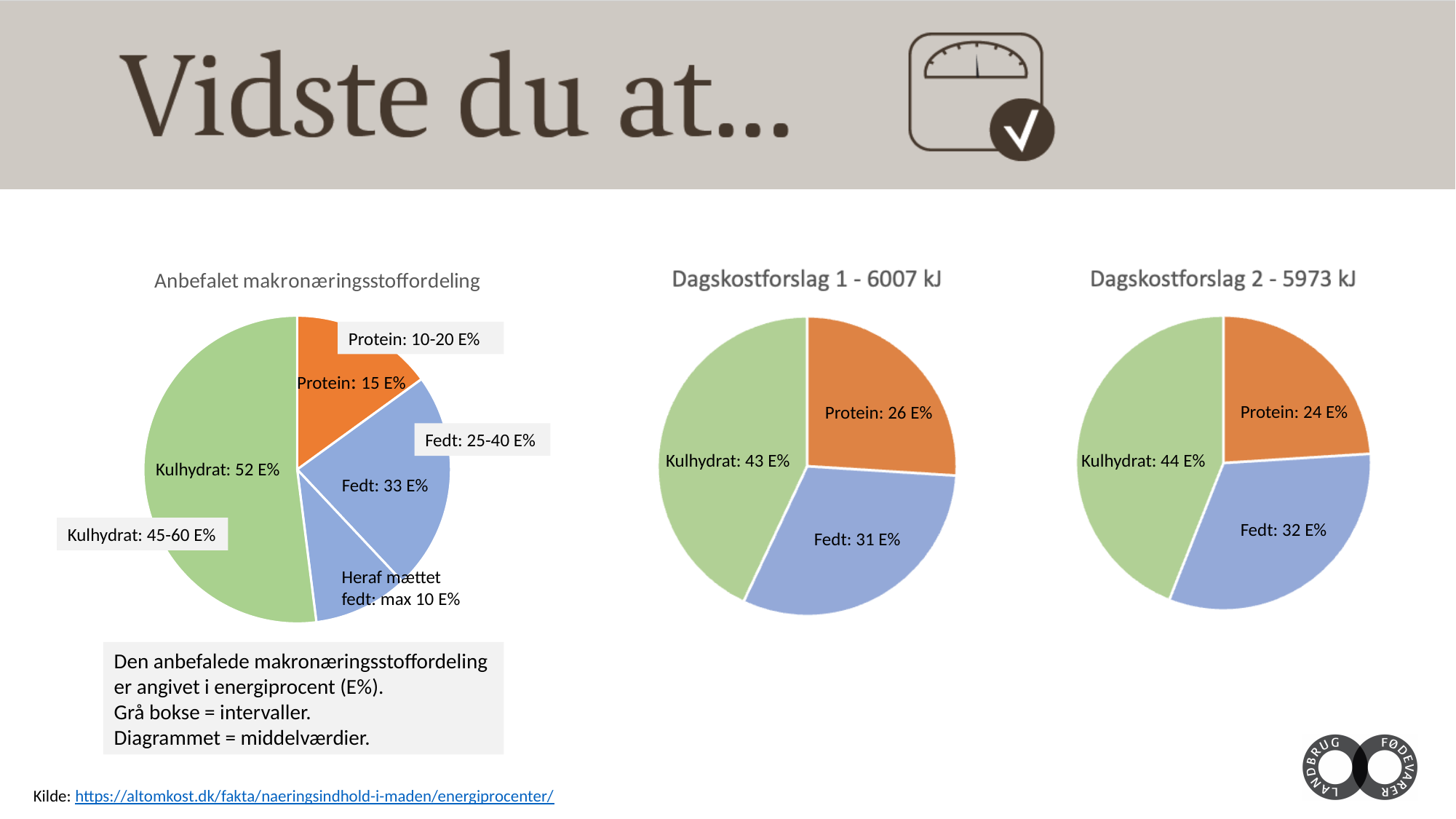
In the chart titled 'Dagskostforslag 1 - 6007 kJ', what is the value for Protein? 26 E% What kind of chart is 'Dagskostforslag 2 - 5973 kJ'? Pie chart In the chart titled 'Anbefalet makronæringsstoffordeling', which category has the smallest slice? Heraf mættet fedt In the chart titled 'Anbefalet makronæringsstoffordeling', what is the value for Kulhydrat? 52 E% In the chart titled 'Dagskostforslag 2 - 5973 kJ', what is the difference between Kulhydrat and Protein? 20 E% In the chart titled 'Dagskostforslag 2 - 5973 kJ', which category has the smallest slice? Protein In the chart titled 'Anbefalet makronæringsstoffordeling', what is the value for Protein? 15 E% In the chart titled 'Dagskostforslag 2 - 5973 kJ', what is the value for Fedt? 32 E% In the chart titled 'Anbefalet makronæringsstoffordeling', which is larger, Fedt or Protein? Fedt In the chart titled 'Dagskostforslag 1 - 6007 kJ', what is the difference between Kulhydrat and Fedt? 12 E% In the chart titled 'Dagskostforslag 1 - 6007 kJ', which category has the largest slice? Kulhydrat How many pie charts are shown on the slide? 3